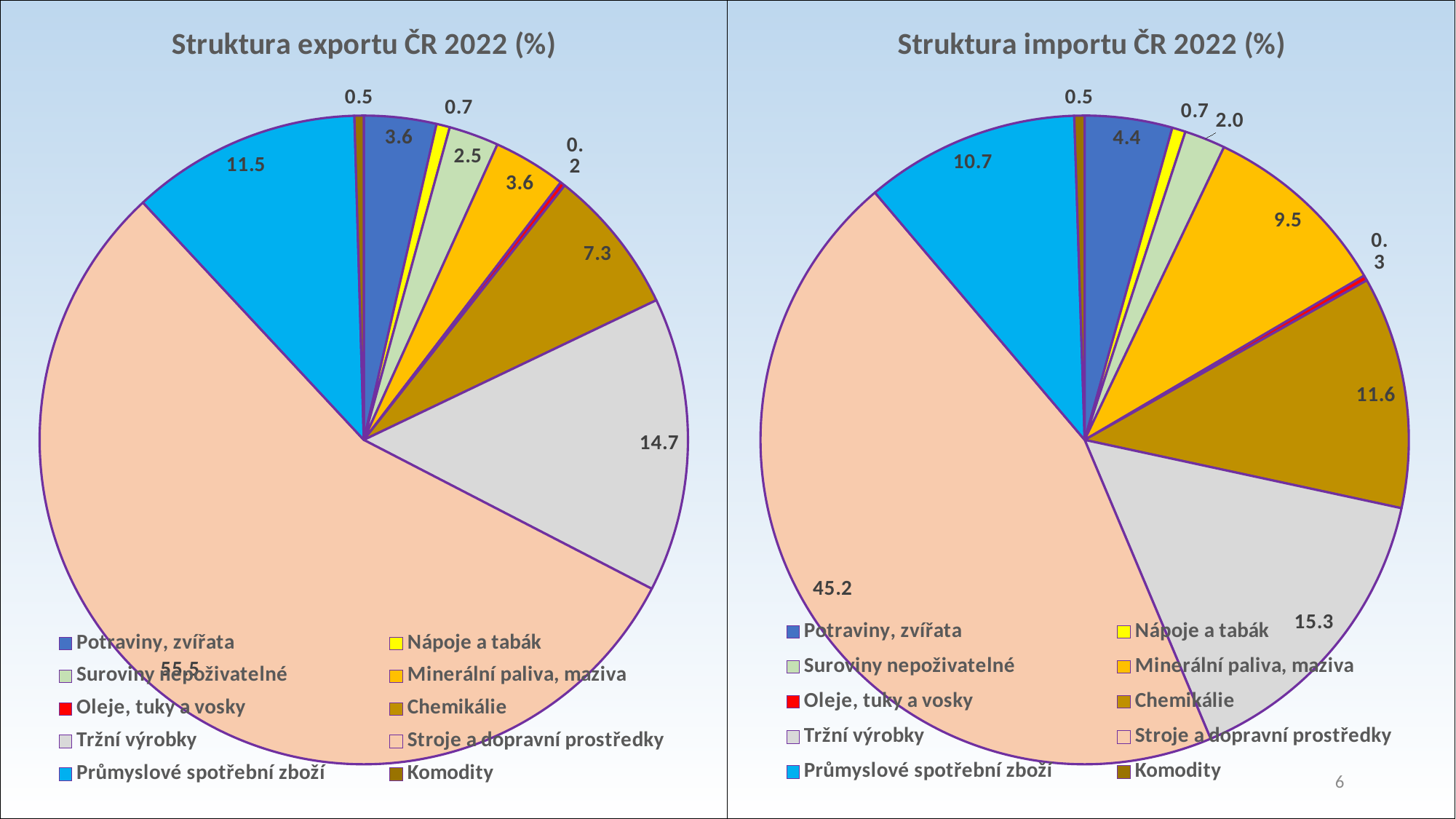
What type of chart is 'Struktura importu ČR 2022 (%)'? Pie chart In the 'Struktura exportu ČR 2022 (%)' chart, what is the value for Tržní výrobky? 14.7 In the 'Struktura importu ČR 2022 (%)' chart, which category has the largest share? Stroje a dopravní prostředky In the 'Struktura exportu ČR 2022 (%)' chart, what is the difference between Tržní výrobky and Průmyslové spotřební zboží? 3.2 In the 'Struktura importu ČR 2022 (%)' chart, what is the value for Minerální paliva, maziva? 9.5 In the 'Struktura exportu ČR 2022 (%)' chart, which category has the smallest share? Oleje, tuky a vosky What is the difference between the Stroje a dopravní prostředky value in the export chart and in the import chart? 10.3 How many categories does the legend of the 'Struktura exportu ČR 2022 (%)' chart list? 10 In the 'Struktura importu ČR 2022 (%)' chart, what is the value for Potraviny, zvířata? 4.4 In the 'Struktura exportu ČR 2022 (%)' chart, what is the value for Stroje a dopravní prostředky? 55.5 In the 'Struktura importu ČR 2022 (%)' chart, what is the value for Chemikálie? 11.6 In the 'Struktura importu ČR 2022 (%)' chart, which is larger: Tržní výrobky or Průmyslové spotřební zboží? Tržní výrobky